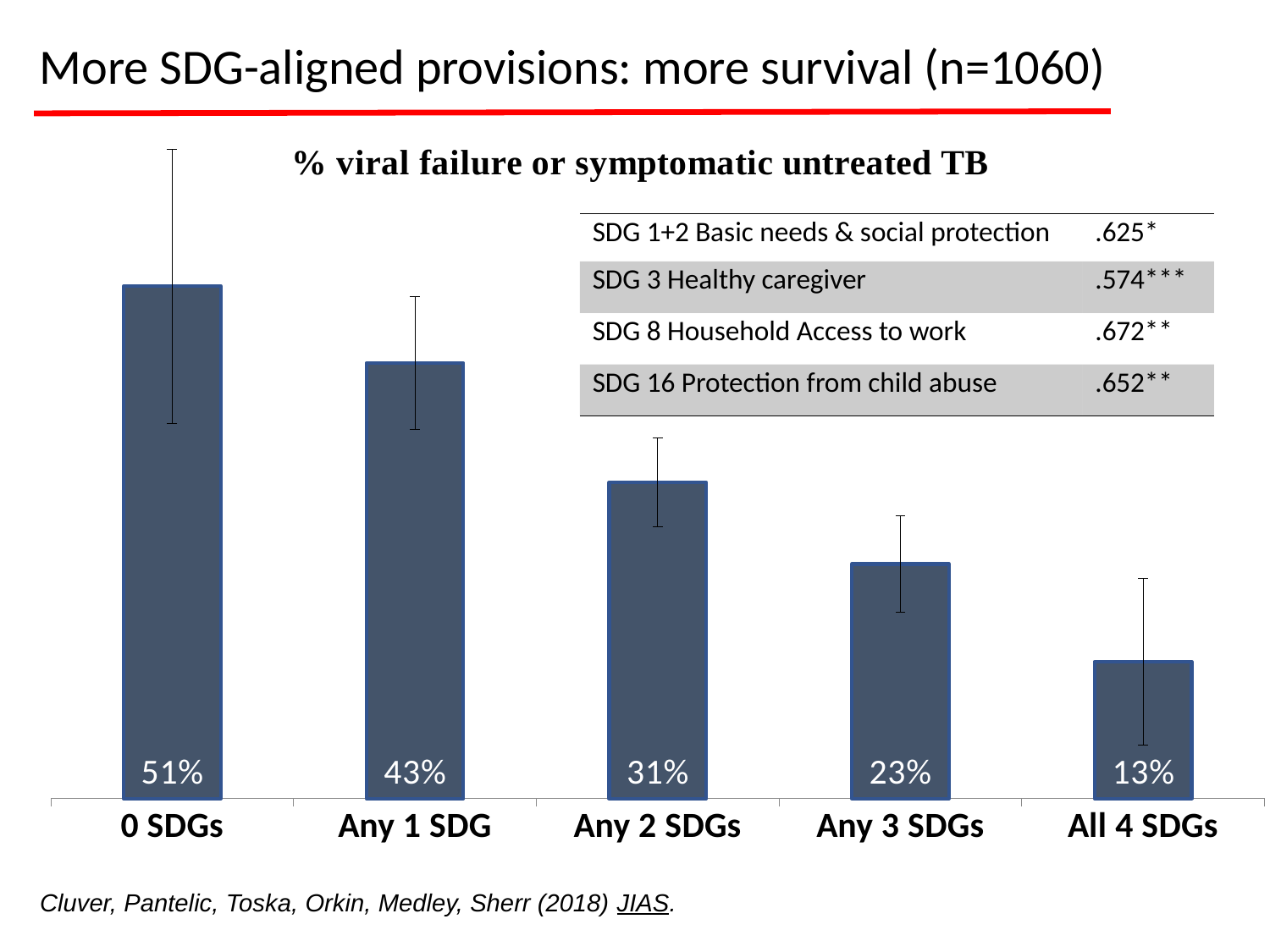
Which category has the lowest value? All 4 SDGs What is the difference between the values for Any 1 SDG and Any 3 SDGs? 20% Do the values rise or fall from left to right along the x axis? Fall What is the value for All 4 SDGs? 13% What is the difference between the values for 0 SDGs and All 4 SDGs? 38% What kind of chart is this? Bar chart Which is larger, the value for Any 1 SDG or the value for Any 2 SDGs? Any 1 SDG Which category has the highest value? 0 SDGs What is the value for Any 2 SDGs? 31% What is the title of the chart? % viral failure or symptomatic untreated TB How many categories are shown on the x axis? 5 What is the value for 0 SDGs? 51%